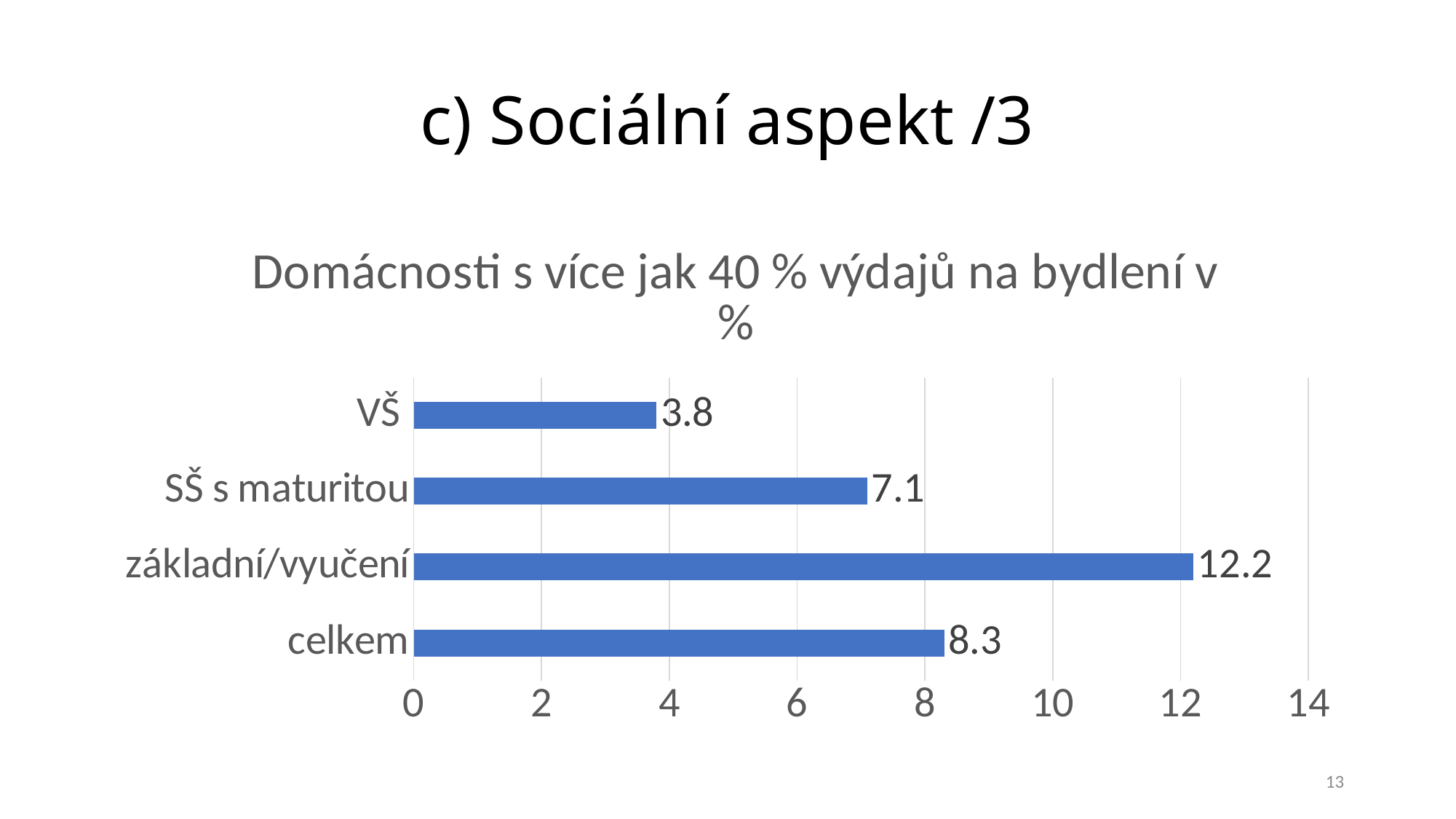
What is the value for SŠ s maturitou? 7.1 Is the value for základní/vyučení greater or less than 10? greater Which category has the lowest value? VŠ What is the difference between the values for celkem and SŠ s maturitou? 1.2 What kind of chart is shown on the slide? bar chart Which category has the highest value? základní/vyučení How many categories are shown in the chart? 4 What is the value for VŠ? 3.8 Which is larger, the value for celkem or the value for SŠ s maturitou? celkem What is the value for celkem? 8.3 What is the difference between the values for základní/vyučení and VŠ? 8.4 What is the value for základní/vyučení? 12.2